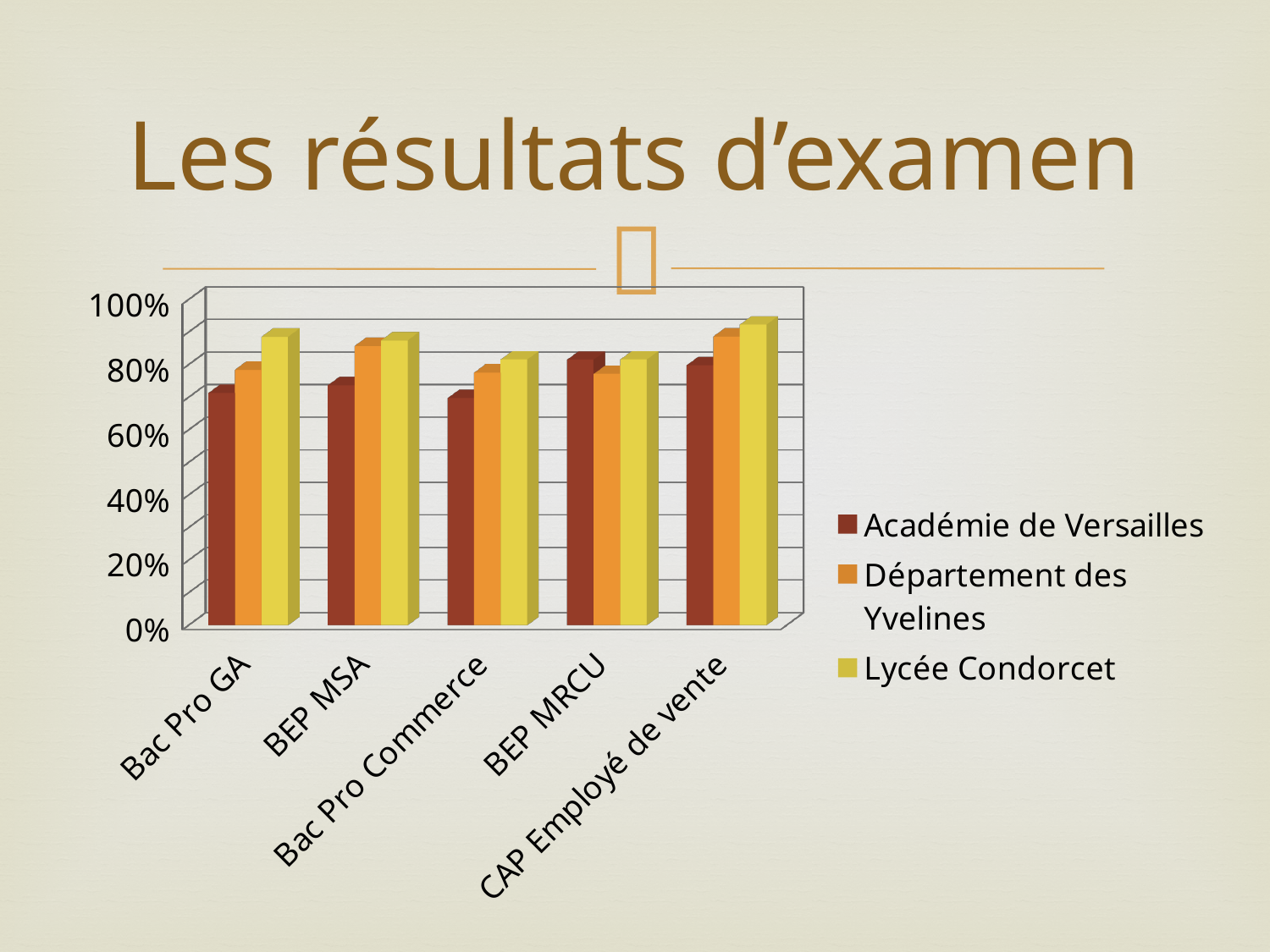
How many series does the chart's legend list? 3 For the Lycée Condorcet series, which category has the highest value? CAP Employé de vente How many categories are shown on the x axis of the chart? 5 What is the title of the slide containing the chart? Les résultats d'examen Is the value for Lycée Condorcet at CAP Employé de vente greater or less than 80%? greater Is the value for Lycée Condorcet at Bac Pro GA greater or less than 80%? greater For BEP MSA, which is larger: the value for Académie de Versailles or for Département des Yvelines? Département des Yvelines Is the value for Académie de Versailles at Bac Pro GA greater or less than 80%? less What kind of chart is shown on the slide? bar chart For Bac Pro GA, which is larger: the value for Académie de Versailles or for Lycée Condorcet? Lycée Condorcet Which series is shown in yellow in the chart? Lycée Condorcet